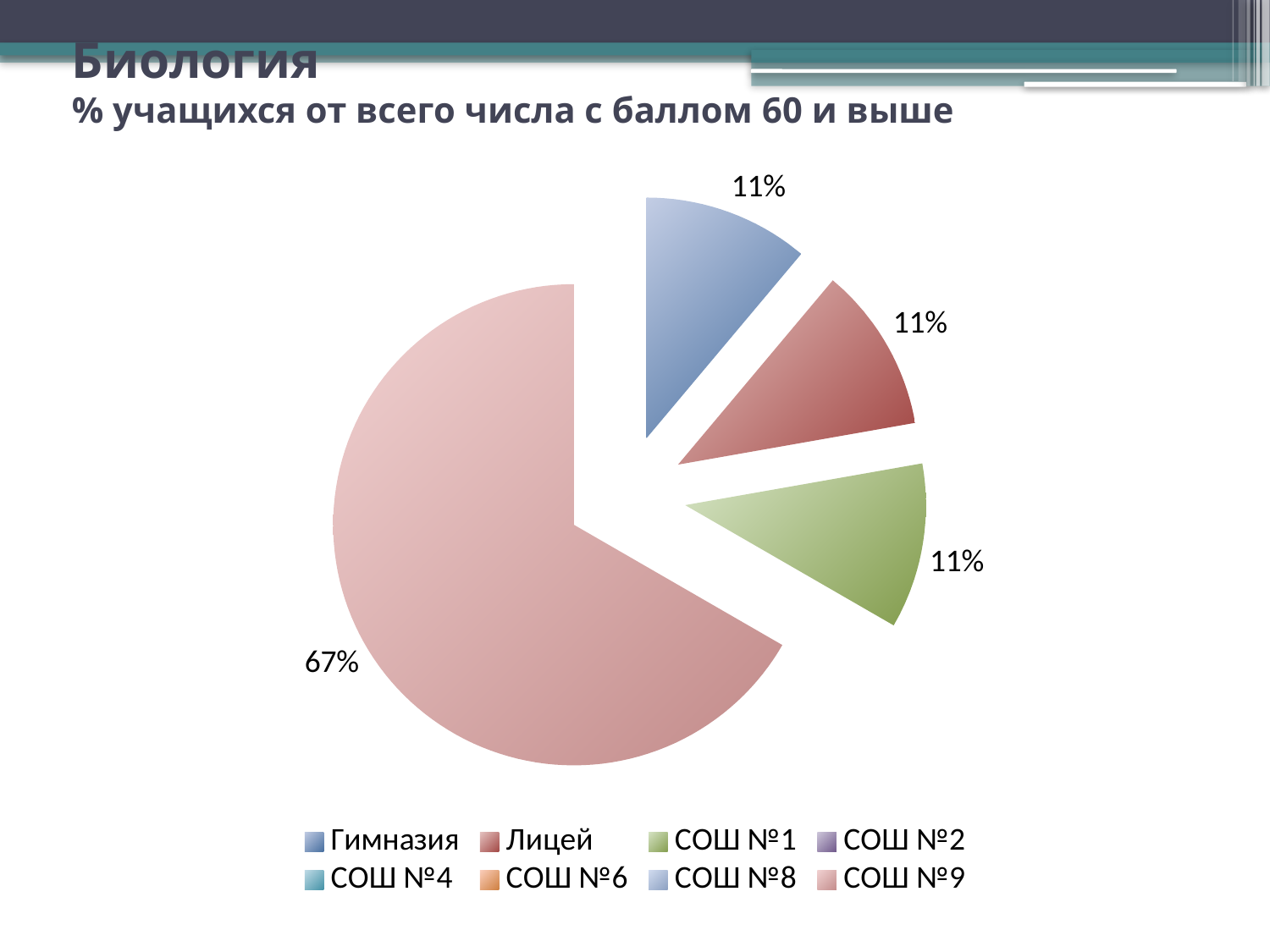
How many slices with data labels are visible in the pie? 4 What share of the pie does СОШ №1 have? 11% Which category has the largest slice of the pie? СОШ №9 Which is larger, the slice for СОШ №9 or the slice for Лицей? СОШ №9 What colour is the slice for СОШ №1? green What kind of chart is shown on the slide? pie chart How many entries does the legend list? 8 What share of the pie does СОШ №9 have? 67% What is the title of the chart? Биология % учащихся от всего числа с баллом 60 и выше What is the difference between the shares of СОШ №9 and Гимназия? 56% What share of the pie does Гимназия have? 11%